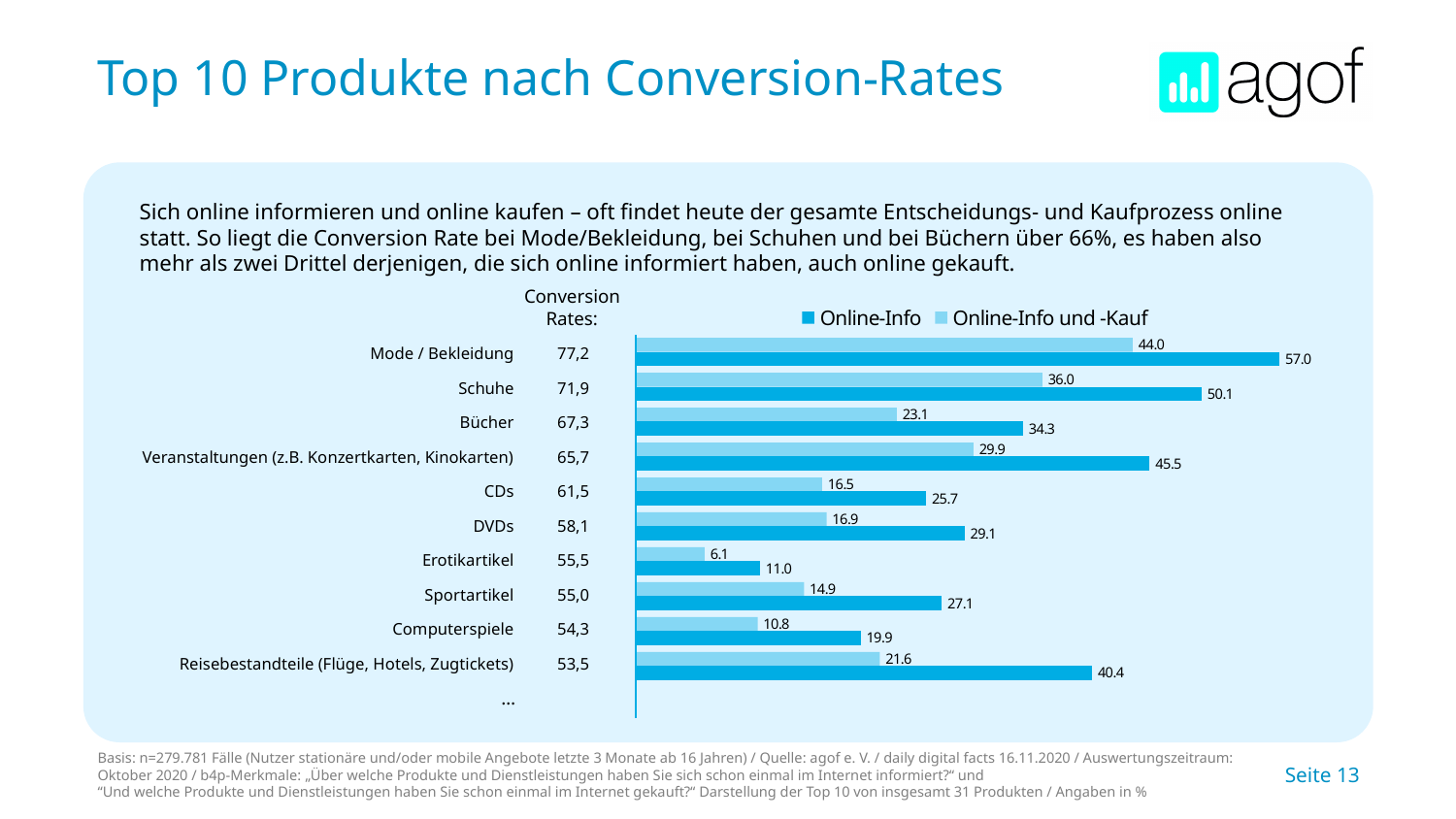
What is the Online-Info value for Reisebestandteile (Flüge, Hotels, Zugtickets)? 40.4 Which product has the lowest Online-Info und -Kauf value? Erotikartikel What is the difference between the Online-Info and the Online-Info und -Kauf values for Schuhe? 14.1 Which has the larger Online-Info value, DVDs or CDs? DVDs What is the difference between the Online-Info and the Online-Info und -Kauf values for Mode / Bekleidung? 13.0 How many series does the legend list? 2 What kind of chart is shown on the slide? Bar chart What is the Online-Info und -Kauf value for Bücher? 23.1 How many products are shown in the chart? 10 What are the two series named in the chart legend? Online-Info and Online-Info und -Kauf Which product has the highest Online-Info value? Mode / Bekleidung What is the Online-Info value for Schuhe? 50.1